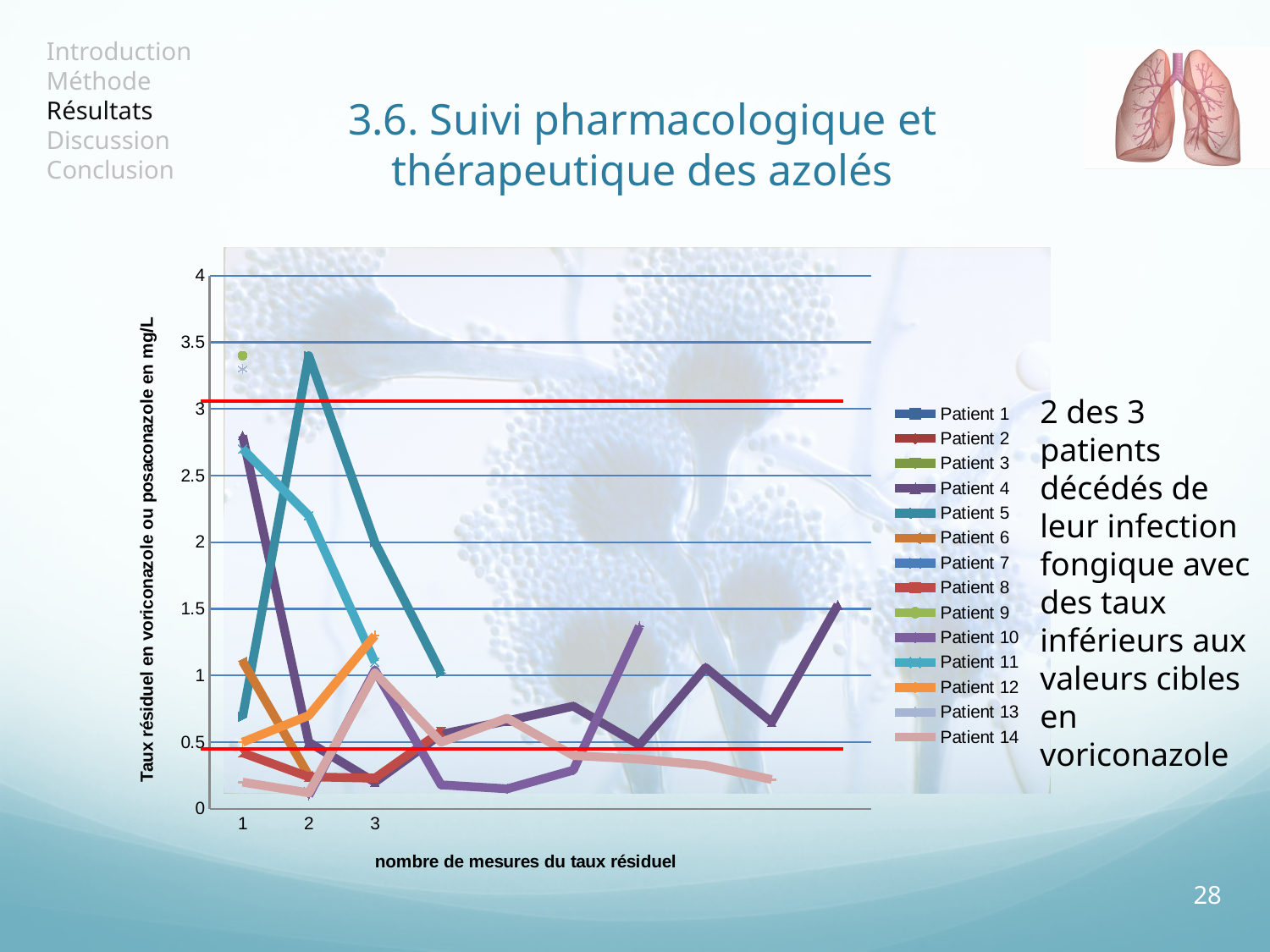
Is the value for Patient 5 at measure 2 greater or less than 3? greater At measure 2, which is larger: the value for Patient 5 or the value for Patient 11? Patient 5 How many series does the legend list? 14 What kind of chart is shown on the slide? line chart Does the value for Patient 11 rise or fall from measure 1 to measure 3? fall Is the value for Patient 5 at measure 1 greater or less than 1? less Is the value for Patient 11 at measure 1 greater or less than 2.5? greater What is the title of the y axis? Taux résiduel en voriconazole ou posaconazole en mg/L Does the value for Patient 5 rise or fall from measure 1 to measure 2? rise What is the title of the x axis? nombre de mesures du taux résiduel